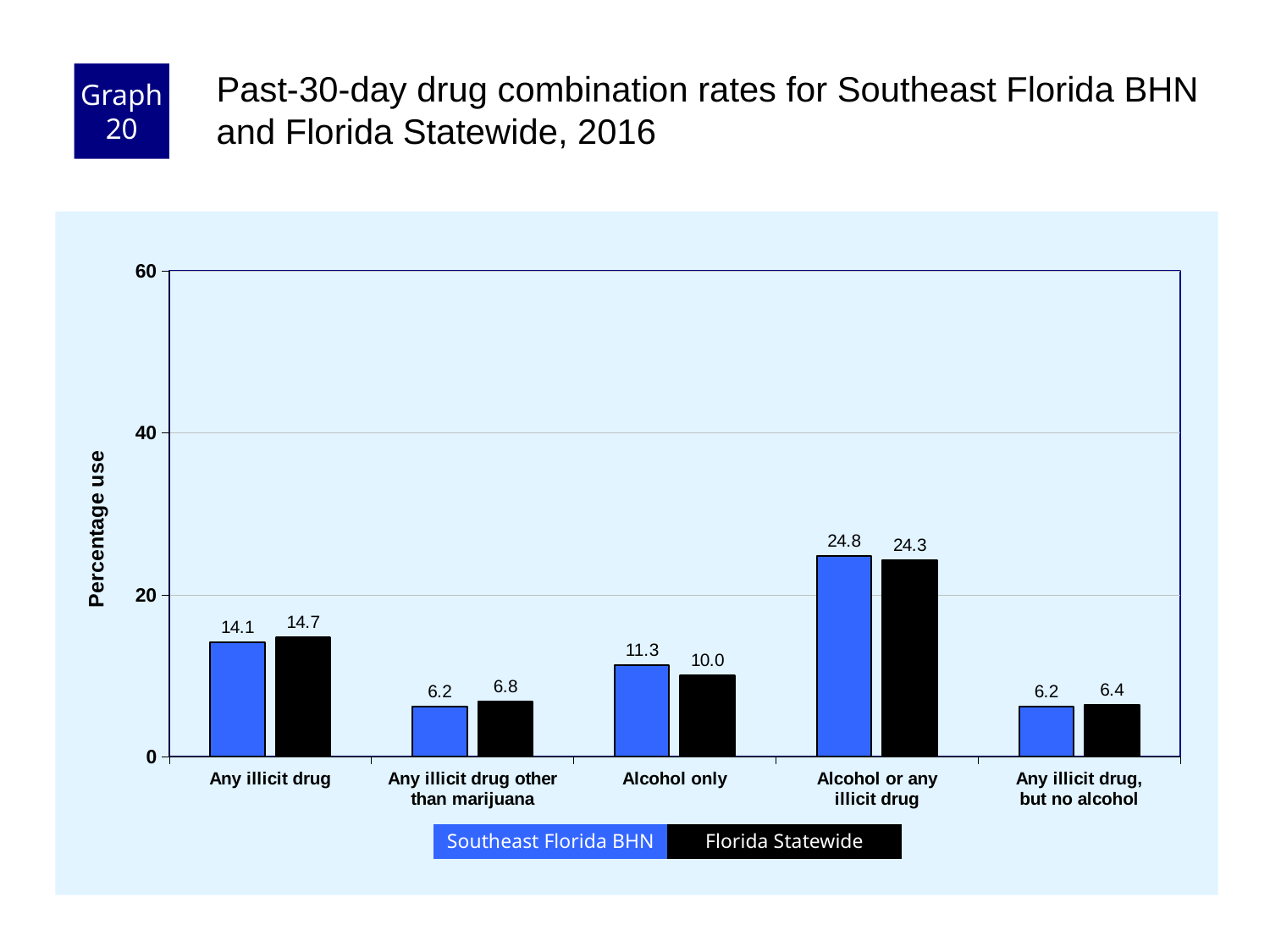
What is the Southeast Florida BHN value for Alcohol only? 11.3 What is the Florida Statewide value for Any illicit drug other than marijuana? 6.8 What is the label of the y axis? Percentage use Which category has the highest Southeast Florida BHN value? Alcohol or any illicit drug What is the difference between the Florida Statewide and Southeast Florida BHN values for Any illicit drug? 0.6 What is the Florida Statewide value for Alcohol or any illicit drug? 24.3 What kind of chart is shown on the slide? Bar chart Is the Southeast Florida BHN value for Alcohol or any illicit drug greater or less than 20? greater How many series does the legend list? 2 How many categories are shown on the x axis? 5 For Alcohol only, which series has the larger value, Southeast Florida BHN or Florida Statewide? Southeast Florida BHN Which category has the lowest Florida Statewide value? Any illicit drug, but no alcohol